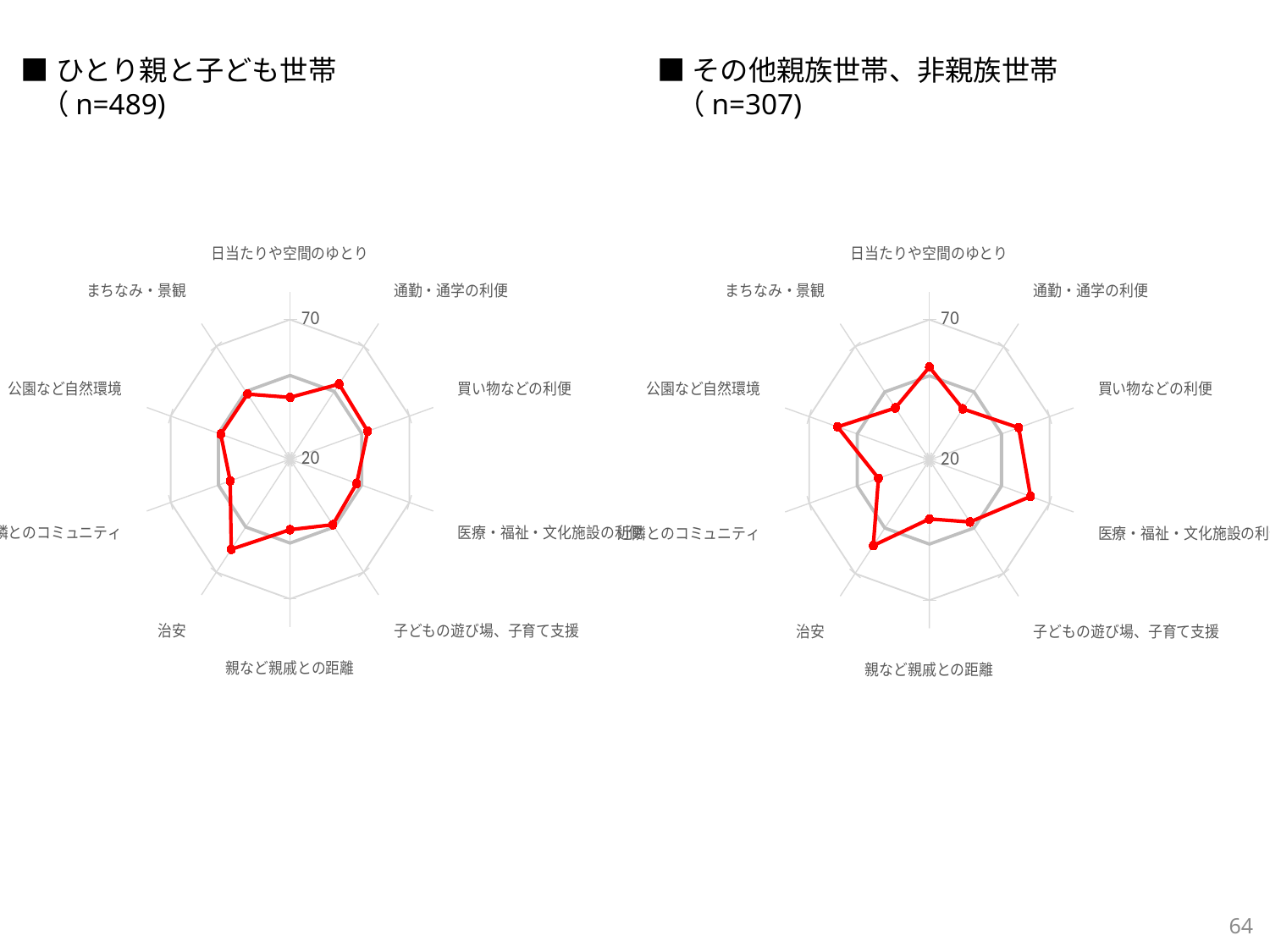
In the right chart (その他親族世帯、非親族世帯), is the red-line value for 医療・福祉・文化施設の利便 greater or less than 70? less In the right chart (その他親族世帯、非親族世帯), which has the larger red-line value: 医療・福祉・文化施設の利便 or 通勤・通学の利便? 医療・福祉・文化施設の利便 What is the sample size (n) given for the left chart, ひとり親と子ども世帯? n=489 How many charts are on the slide? 2 In the right chart (その他親族世帯、非親族世帯), how many categories (axes) are plotted? 10 What kind of chart is shown on the left side of the slide (ひとり親と子ども世帯)? Radar chart What is the sample size (n) given for the right chart, その他親族世帯、非親族世帯? n=307 In the left chart (ひとり親と子ども世帯), which category has the highest value on the red line? 治安 What kind of chart is shown on the right side of the slide (その他親族世帯、非親族世帯)? Radar chart In the left chart (ひとり親と子ども世帯), is the red-line value for 治安 greater or less than 70? less In the left chart (ひとり親と子ども世帯), how many categories (axes) are plotted? 10 In the left chart (ひとり親と子ども世帯), which has the larger red-line value: 治安 or 日当たりや空間のゆとり? 治安